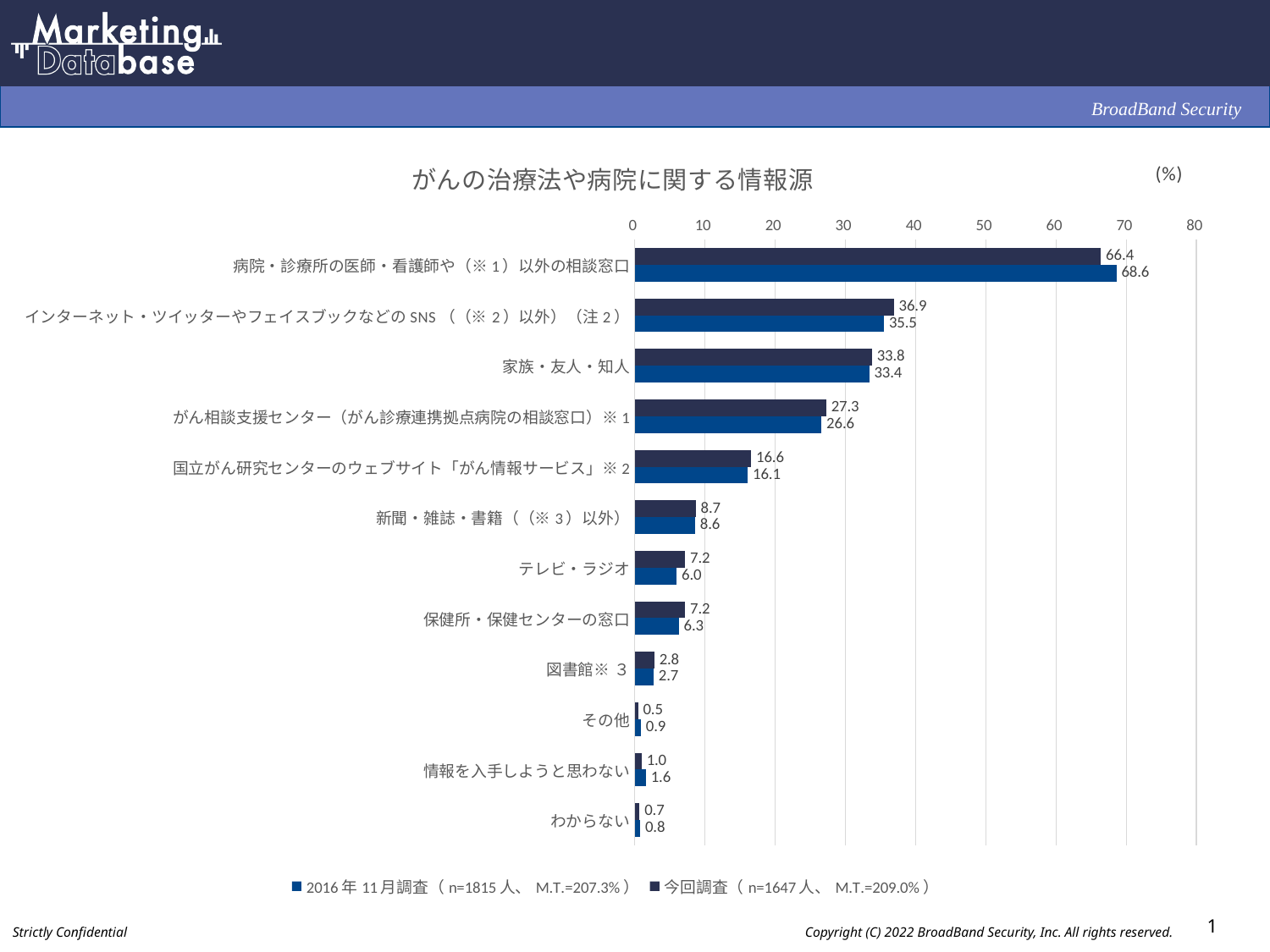
What is the title of the chart? がんの治療法や病院に関する情報源 Which category has the highest value in the 今回調査 series? 病院・診療所の医師・看護師や（※1）以外の相談窓口 How many categories are plotted on the chart? 12 What is the value for テレビ・ラジオ in the 2016年11月調査 series? 6.0 Which category has the lowest value in the 今回調査 series? その他 What is the sample size (n) shown in the legend for the 今回調査 series? 1647人 What is the value for 家族・友人・知人 in the 今回調査 series? 33.8 For がん相談支援センター（がん診療連携拠点病院の相談窓口）※1, which series has the larger value, 今回調査 or 2016年11月調査? 今回調査 How many series does the legend list? 2 What is the difference between the 今回調査 and 2016年11月調査 values for インターネット・ツイッターやフェイスブックなどのSNS（（※2）以外）（注2）? 1.4 What type of chart is shown on the slide? bar chart What is the value for 病院・診療所の医師・看護師や（※1）以外の相談窓口 in the 2016年11月調査 series? 68.6